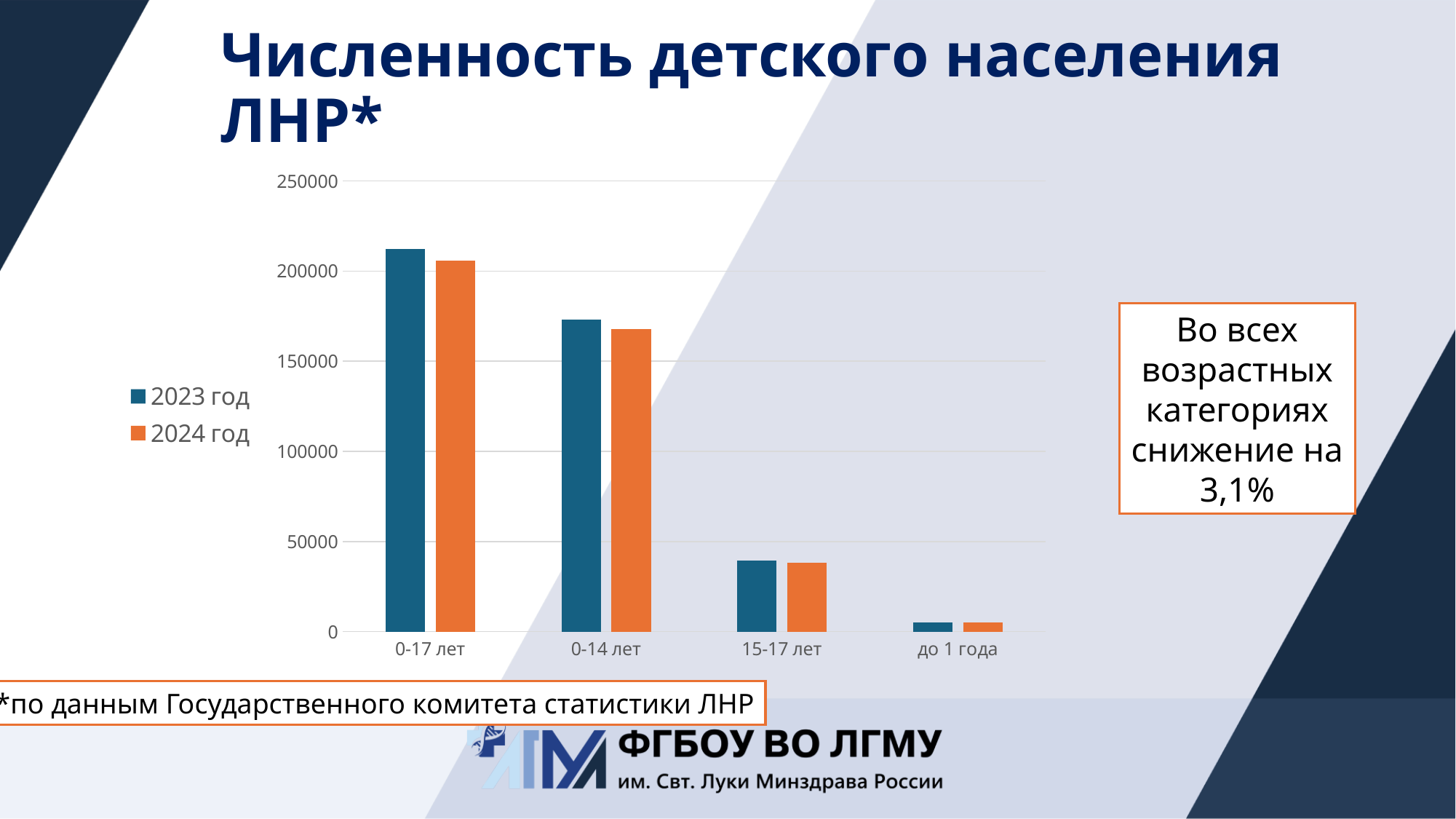
Which is larger: the 2023 год value for 0-17 лет or the 2023 год value for 0-14 лет? 0-17 лет How many age categories are shown on the x axis of the chart? 4 Which series is shown in orange in the chart legend? 2024 год Is the value for до 1 года in 2024 год greater or less than 50000? less Is the value for 15-17 лет in 2023 год greater or less than 50000? less Is the value for 0-14 лет in 2024 год greater or less than 150000? greater How many series does the chart legend list? 2 Which age category has the highest value for 2023 год? 0-17 лет What kind of chart is shown on the slide? bar chart What is the title of the slide containing the chart? Численность детского населения ЛНР* Which age category has the lowest value for 2024 год? до 1 года